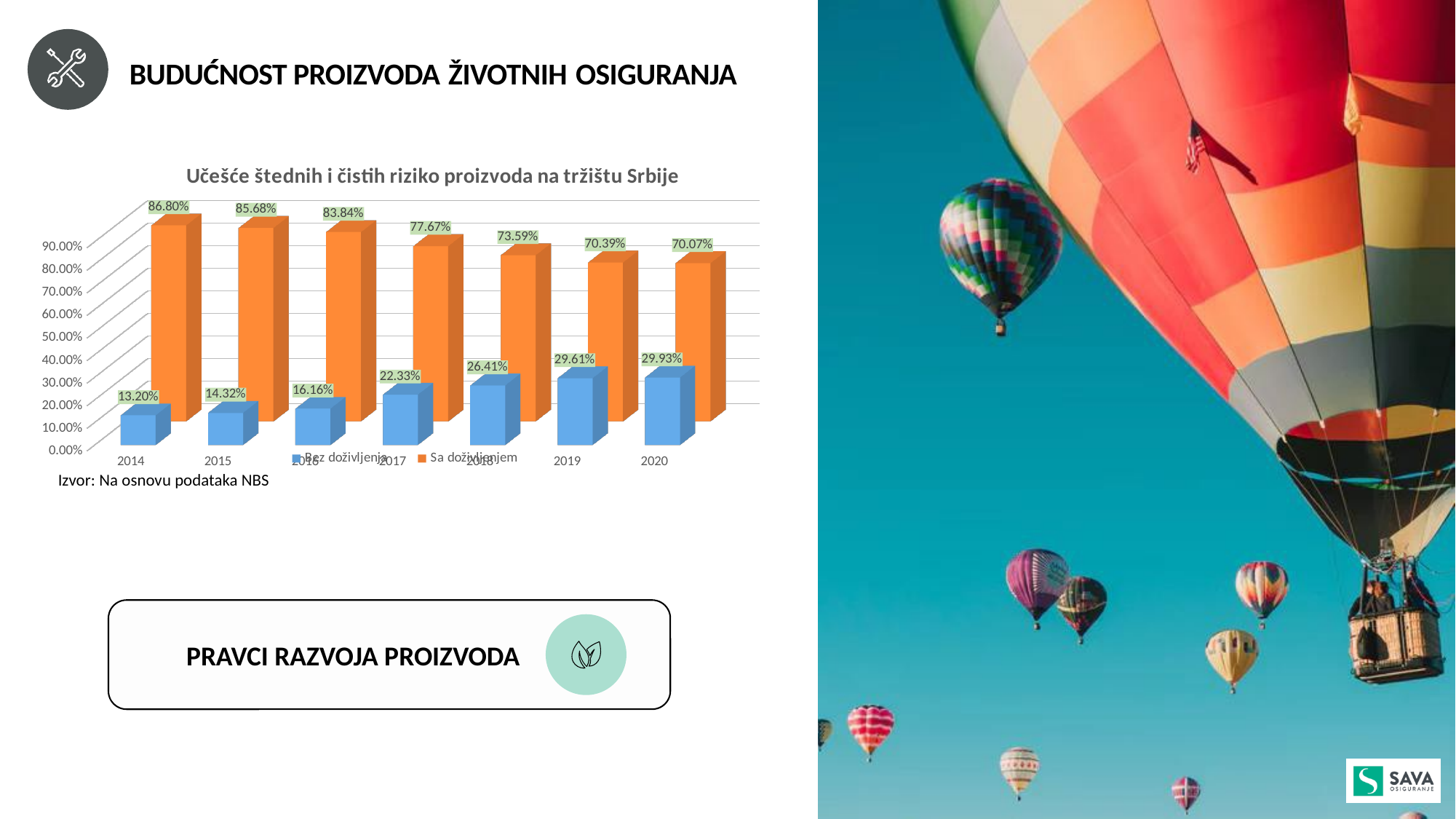
What is the value for Sa doživljenjem in 2014? 86.80% What is the difference between the Sa doživljenjem and Bez doživljenja values in 2019? 40.78% What is the value for Bez doživljenja in 2020? 29.93% What kind of chart is shown on the slide? Bar chart How many years are shown on the x axis? 7 Which is larger, the Bez doživljenja value in 2016 or in 2017? 2017 What is the value for Sa doživljenjem in 2017? 77.67% In which year is the value for Bez doživljenja lowest? 2014 What is the value for Bez doživljenja in 2018? 26.41% Does the value for Sa doživljenjem rise or fall from 2014 to 2020? Fall In which year is the value for Sa doživljenjem highest? 2014 How many series does the legend list? 2